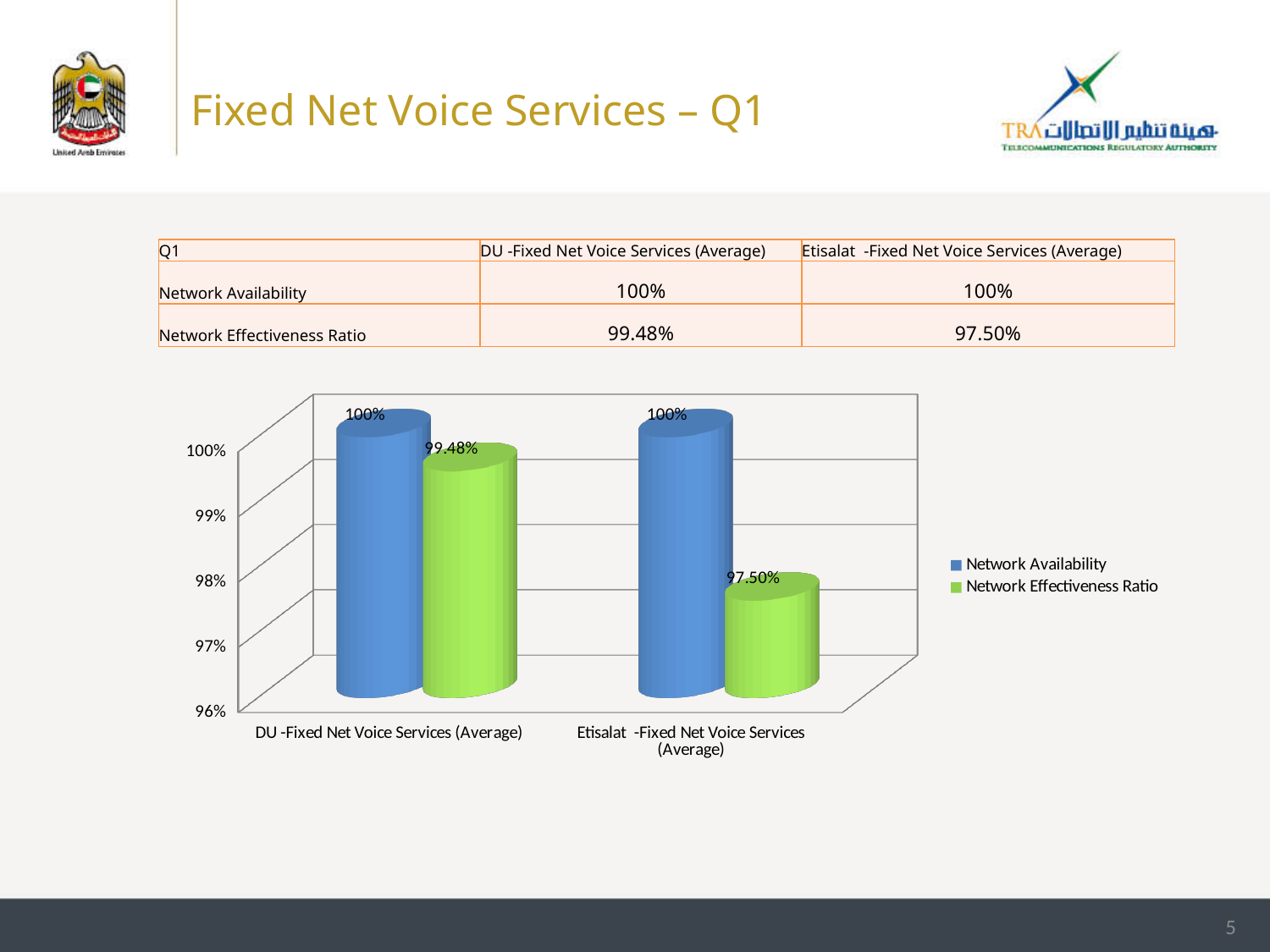
What is the Network Effectiveness Ratio for DU - Fixed Net Voice Services (Average)? 99.48% Is the Network Effectiveness Ratio for DU greater or less than 99%? greater Which operator has the lower Network Effectiveness Ratio? Etisalat - Fixed Net Voice Services (Average) What kind of chart is shown on the slide? Bar chart How many operator categories are shown on the x axis? 2 Which operator has the higher Network Effectiveness Ratio? DU - Fixed Net Voice Services (Average) What is the Network Availability value for Etisalat - Fixed Net Voice Services (Average)? 100% What is the difference between the Network Effectiveness Ratio of DU and Etisalat? 1.98% How many series does the legend list? 2 What is the Network Availability value for DU - Fixed Net Voice Services (Average)? 100% Is the Network Effectiveness Ratio for Etisalat greater or less than 98%? less What is the Network Effectiveness Ratio for Etisalat - Fixed Net Voice Services (Average)? 97.50%